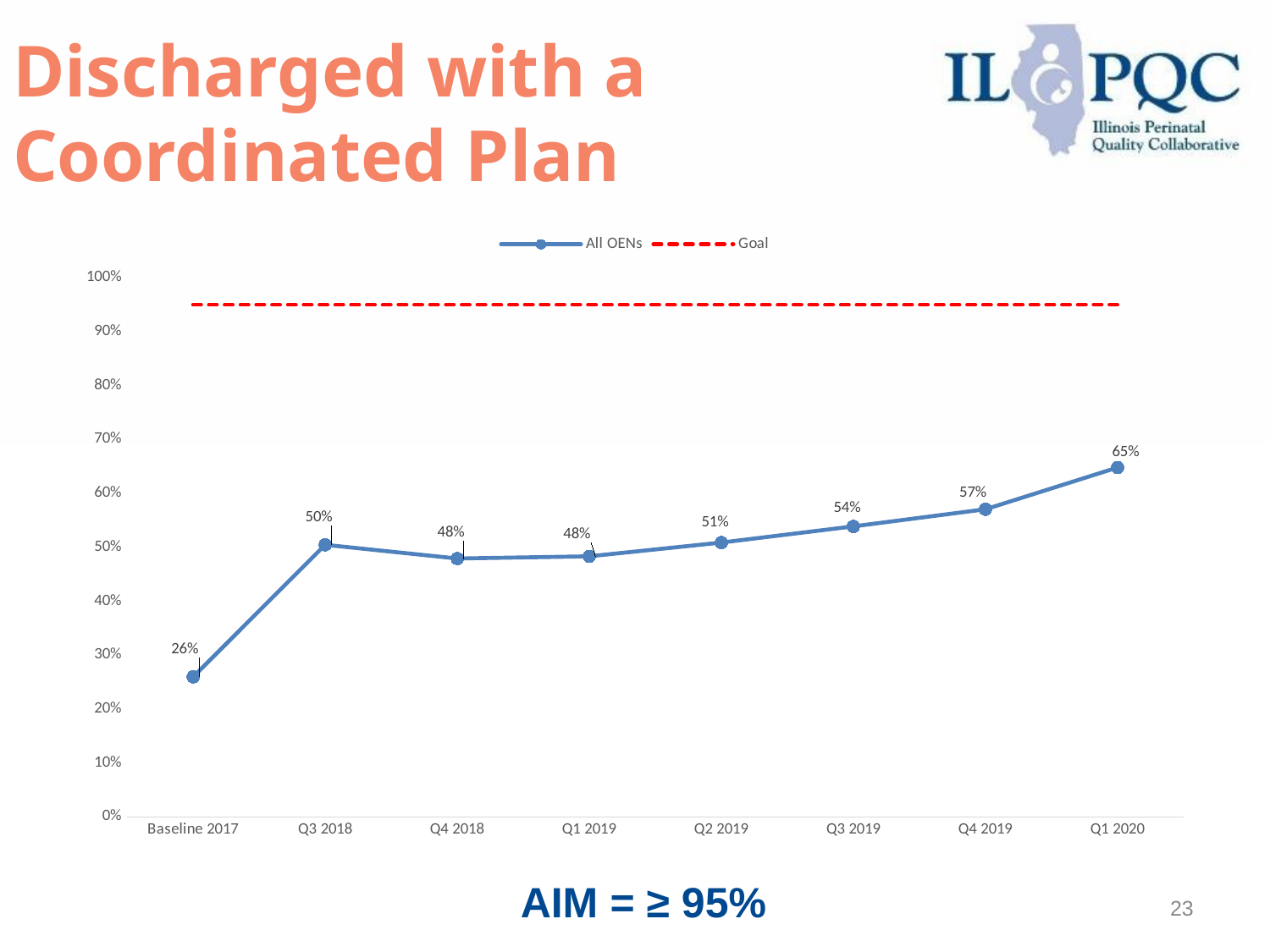
Do the All OENs values rise or fall from Q1 2019 to Q1 2020? rise What is the difference between the All OENs values for Q1 2020 and Baseline 2017? 39% Is the Goal line greater or less than 90%? greater How many time periods are shown on the x axis? 8 What kind of chart is shown on the slide? line chart What is the value for All OENs in Q2 2019? 51% Which period has the highest value for All OENs? Q1 2020 What is the value for All OENs at Baseline 2017? 26% Which is larger, the All OENs value for Q3 2018 or for Q4 2018? Q3 2018 Which period has the lowest value for All OENs? Baseline 2017 What is the value for All OENs in Q1 2020? 65% How many series does the legend list? 2